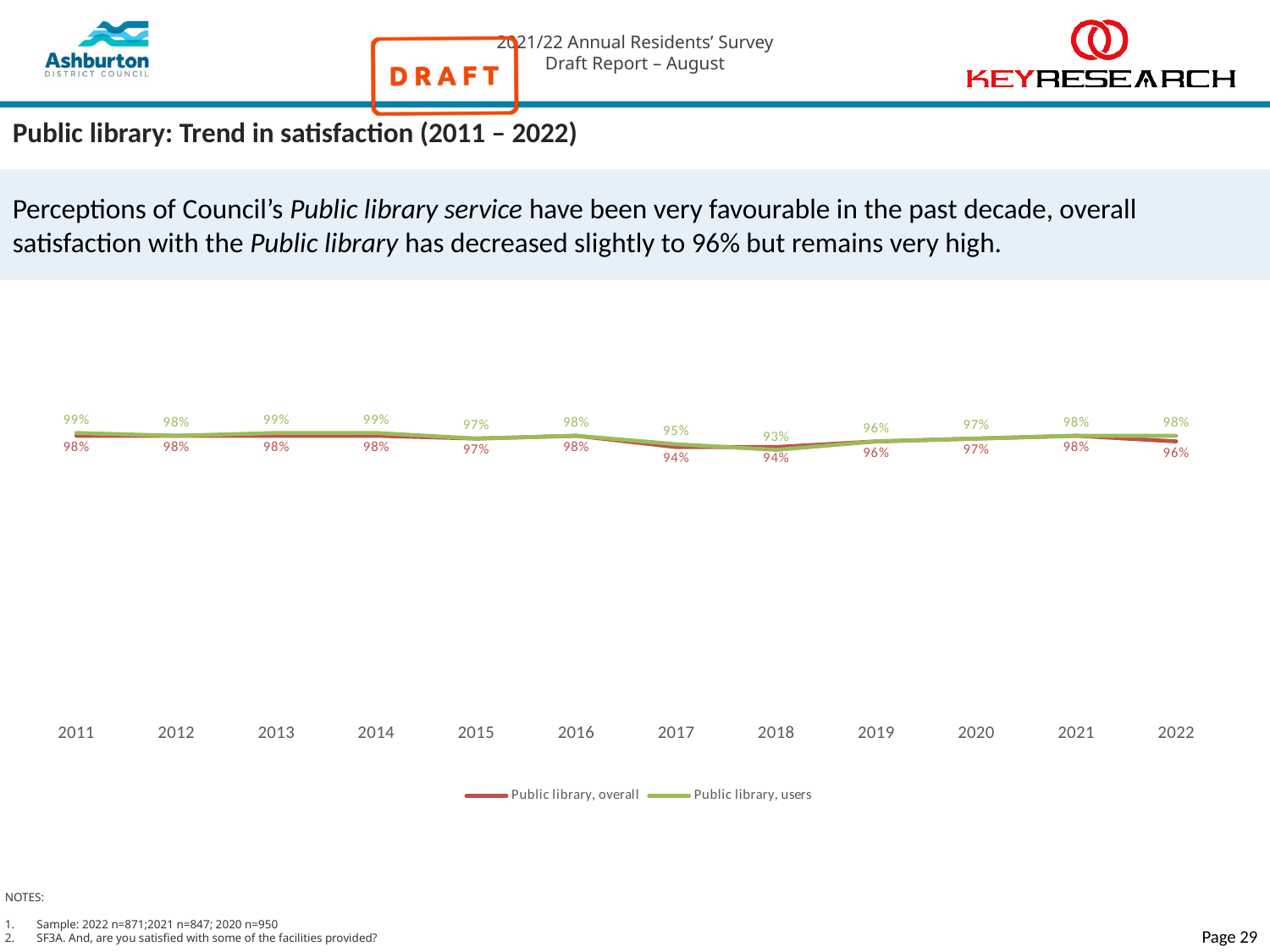
What is the difference between the Public library, users values in 2014 and 2018? 6% In which year is the Public library, users series at its lowest? 2018 Which is higher in 2011: Public library, overall or Public library, users? Public library, users What is the value for Public library, users in 2018? 93% What is the value for Public library, overall in 2017? 94% Did the Public library, overall value rise or fall from 2021 to 2022? Fall How many series does the legend list? 2 How many years are plotted along the x axis? 12 What is the title of the chart on the slide? Public library: Trend in satisfaction (2011 – 2022) What is the value for Public library, overall in 2022? 96% What is the difference between Public library, users and Public library, overall in 2022? 2% What type of chart is shown on the slide? Line chart